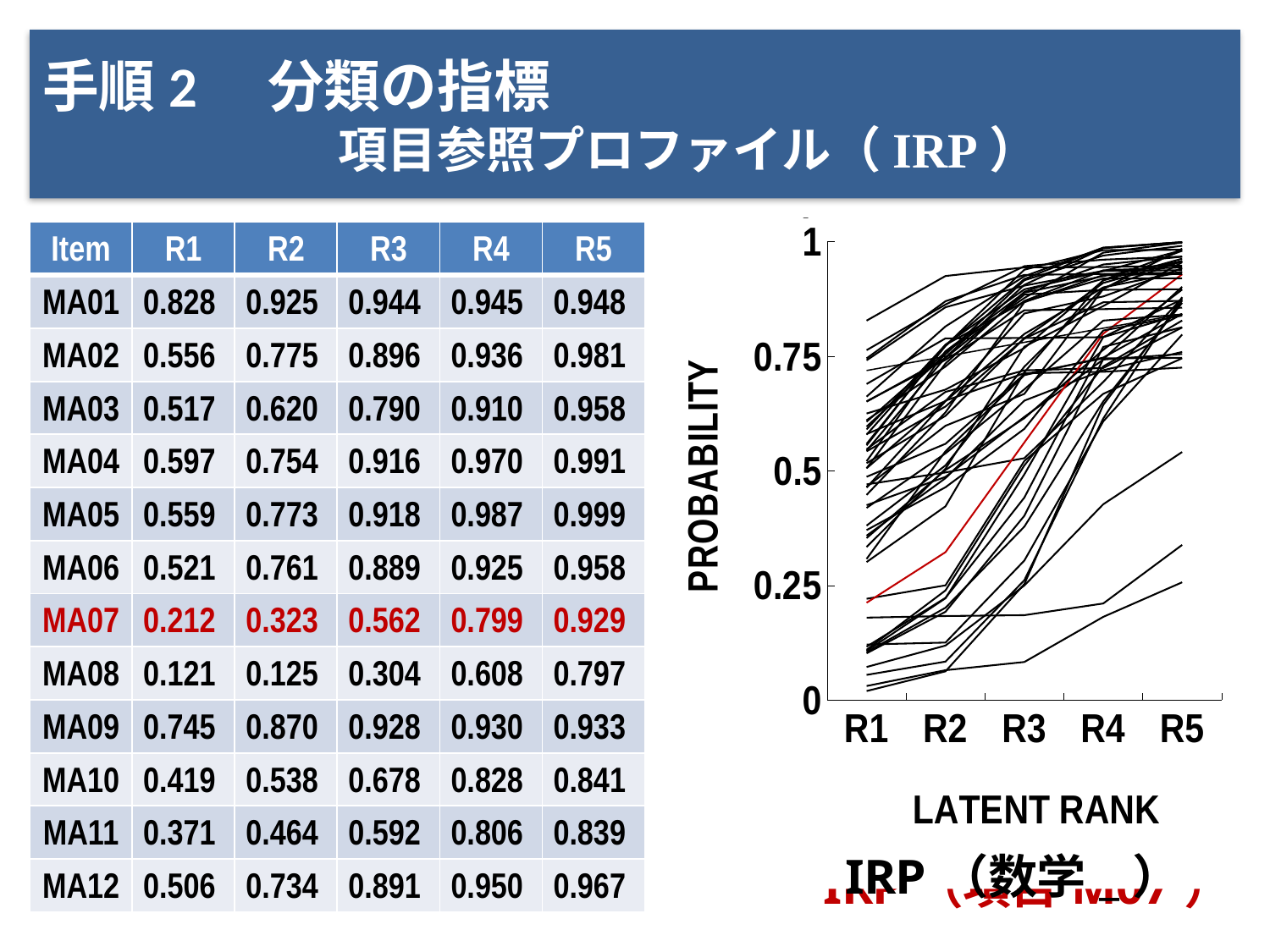
Is the value of the red line at R2 greater or less than 0.5? less What kind of chart is shown on the right of the slide? line chart Is the value of the red line at R5 greater or less than 0.75? greater What is the label of the x axis of the chart? LATENT RANK Is the value of the red line at R1 greater or less than 0.25? less At which latent rank does the red line reach its lowest value? R1 At which latent rank does the red line reach its highest value? R5 What is the label of the y axis of the chart? PROBABILITY Do the lines in the chart generally rise or fall from R1 to R5? rise How many latent rank categories are shown on the x axis of the chart? 5 Is the value of the red line larger at R4 or at R2? R4